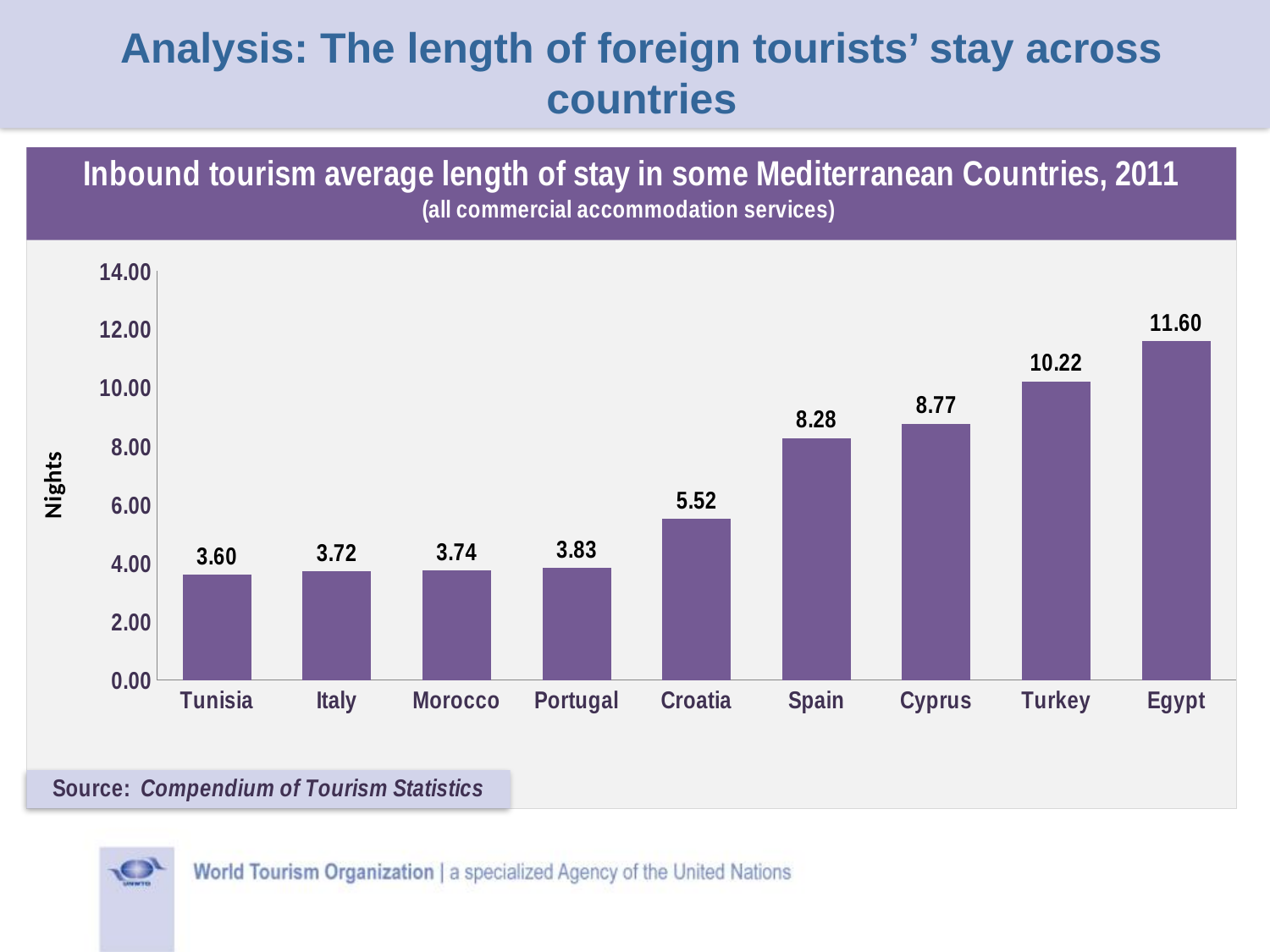
Do the values rise or fall from Tunisia to Egypt along the x axis? Rise Which has a longer average length of stay, Cyprus or Spain? Cyprus Which country has the lowest average length of stay? Tunisia What is the label of the vertical axis? Nights Which country has the highest average length of stay? Egypt What is the average length of stay for Croatia? 5.52 What is the average length of stay for Spain? 8.28 What is the difference between the average length of stay in Egypt and in Turkey? 1.38 What is the difference between the average length of stay in Cyprus and in Tunisia? 5.17 What kind of chart is shown on the slide? Bar chart How many countries are shown in the chart? 9 Is the value for Turkey greater or less than 10.00? greater